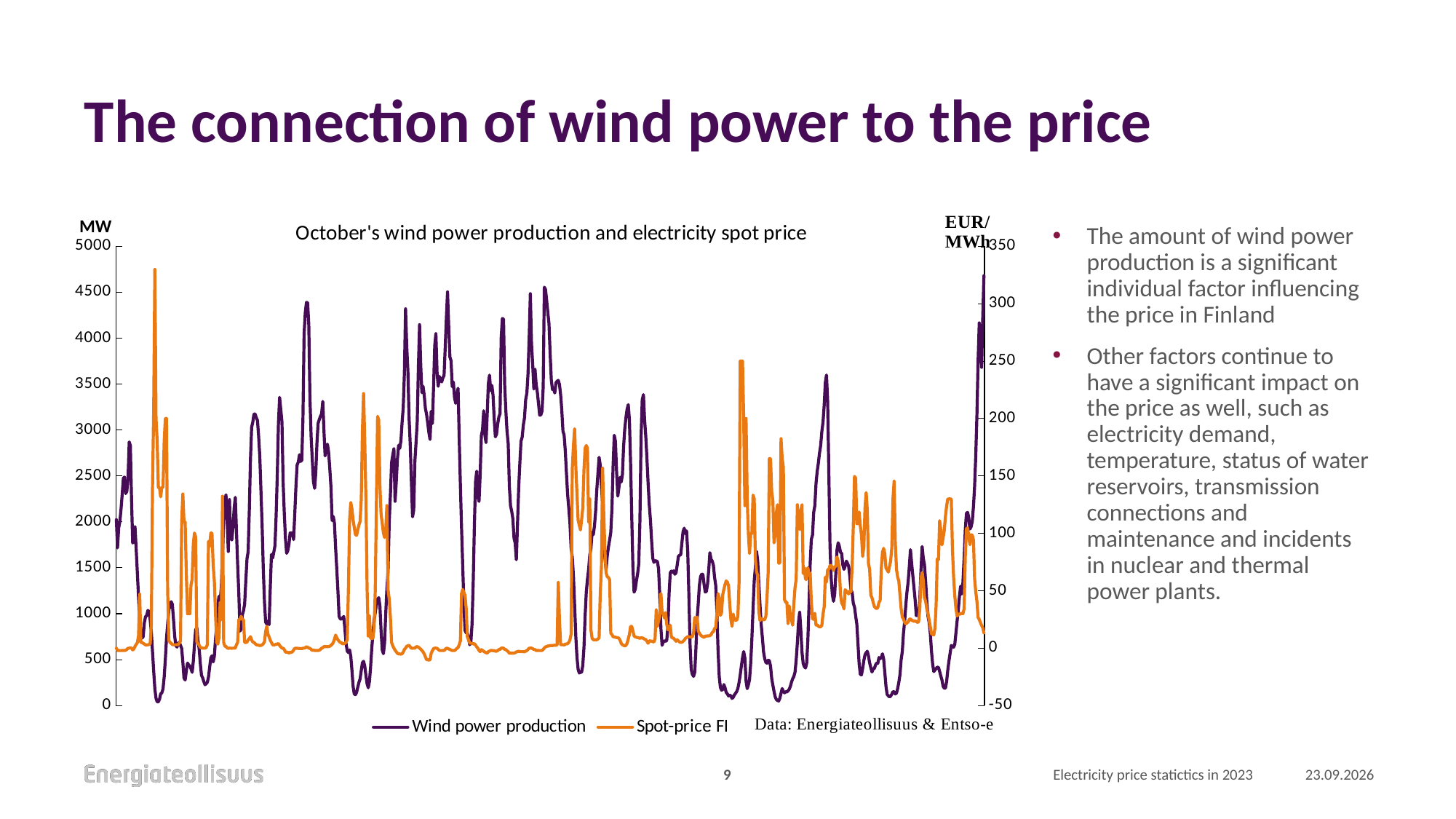
Is the highest value of the Spot-price FI series greater or less than 300 EUR/MWh? greater What is the minimum tick value shown on the right (EUR/MWh) axis? -50 What kind of chart is shown on the slide? line chart Is the highest value of the Spot-price FI series greater or less than 350 EUR/MWh? less Is the highest value of the Wind power production series greater or less than 4000 MW? greater What is the maximum tick value shown on the left (MW) axis? 5000 How many series does the chart's legend list? 2 What is the maximum tick value shown on the right (EUR/MWh) axis? 350 What are the two series named in the chart's legend? Wind power production and Spot-price FI What is the title of the chart? October's wind power production and electricity spot price